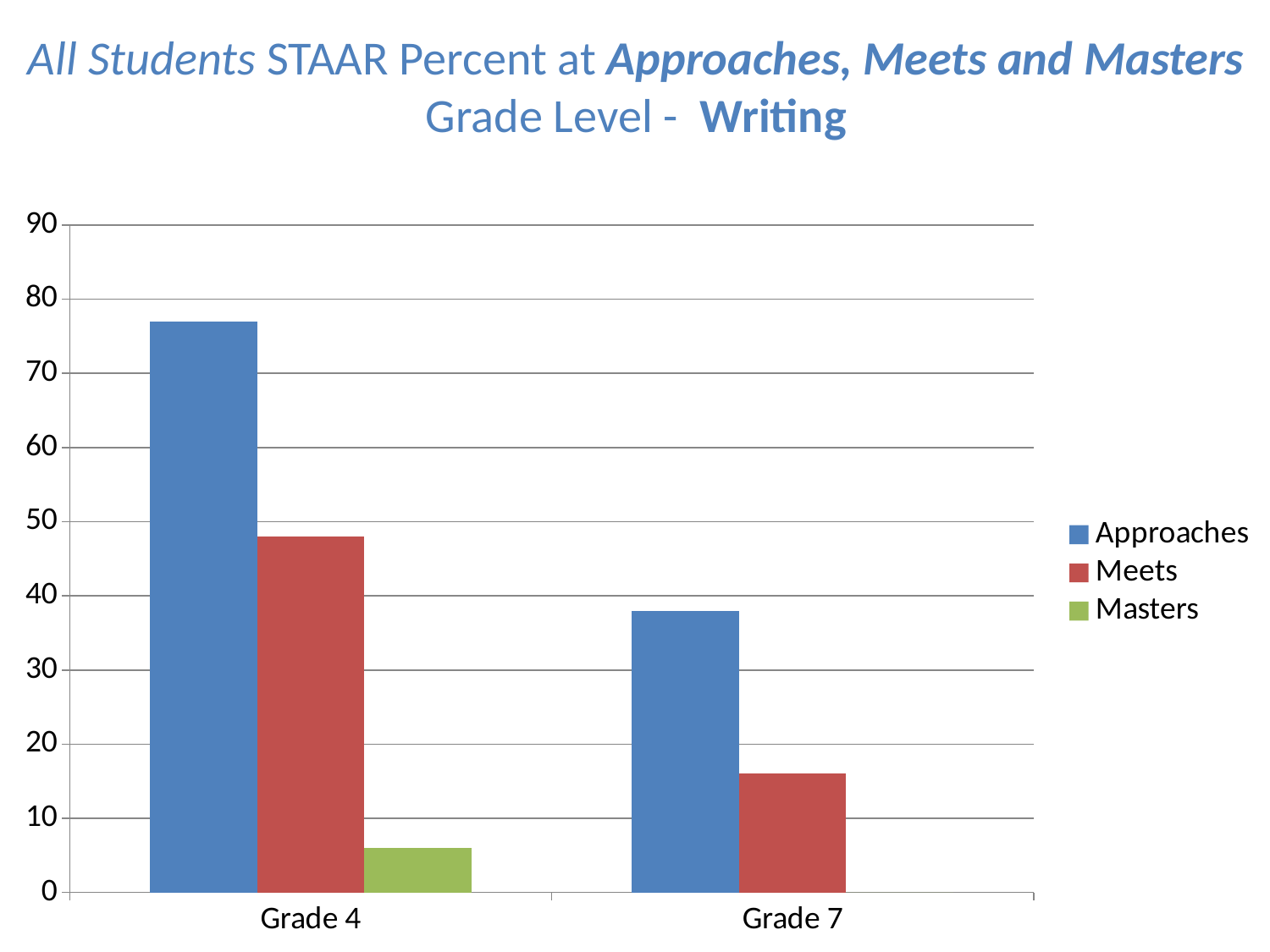
How many series does the legend list? 3 Is the Approaches value for Grade 4 greater or less than 70? greater Which series has the highest value for Grade 4? Approaches How many grade-level categories are shown on the x axis? 2 Which is larger: Meets for Grade 4 or Approaches for Grade 7? Meets for Grade 4 What colour represents the Masters series in the legend? green Is the Meets value for Grade 7 greater or less than 10? greater What kind of chart is shown on the slide? bar chart Is the Approaches value for Grade 7 greater or less than 40? less Which series has the lowest value for Grade 4? Masters Which grade has the larger Approaches value, Grade 4 or Grade 7? Grade 4